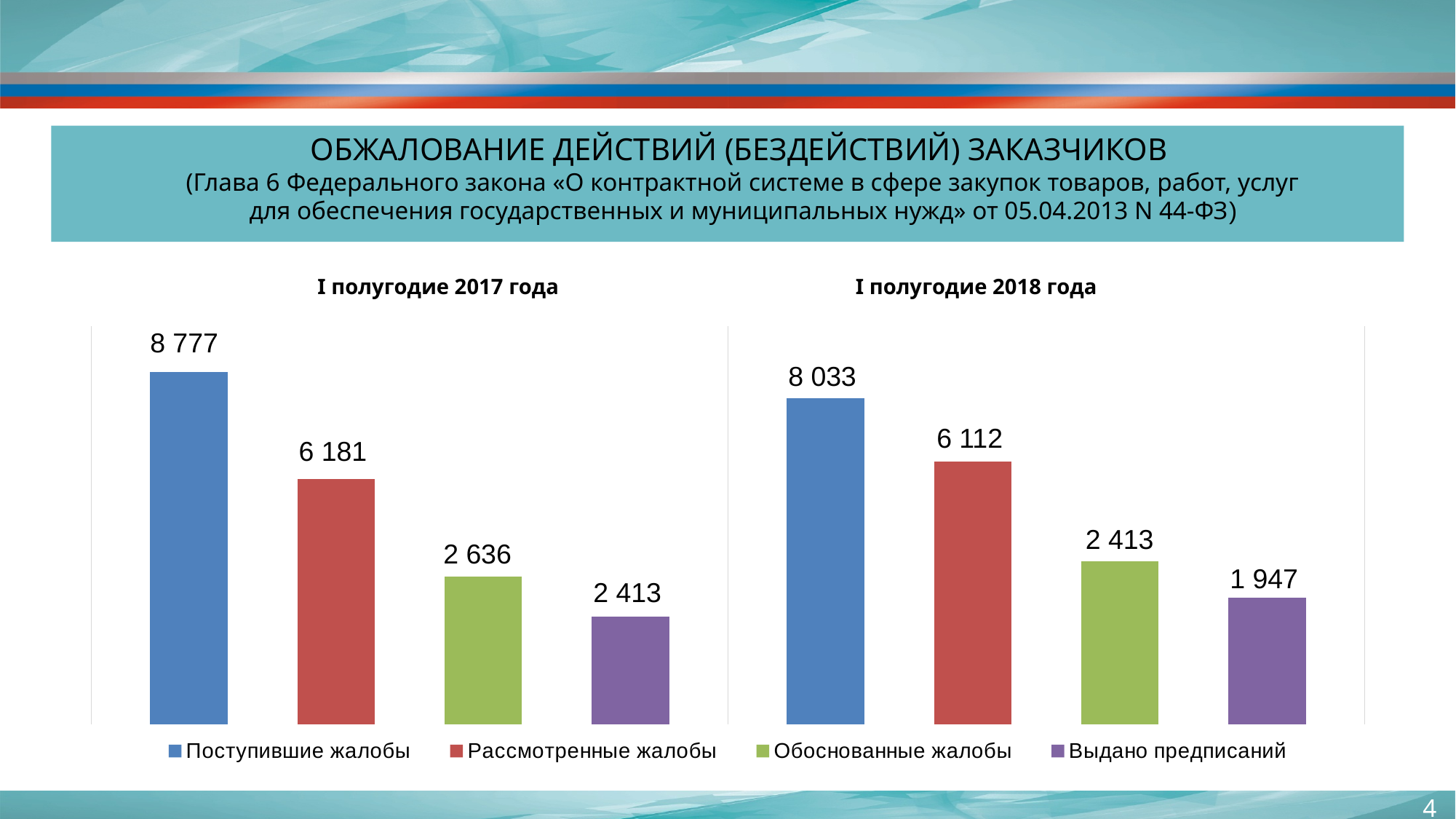
Which period has the larger value for Выдано предписаний, I полугодие 2017 года or I полугодие 2018 года? I полугодие 2017 года Which series has the lowest value in I полугодие 2017 года? Выдано предписаний What is the value for Поступившие жалобы in I полугодие 2017 года? 8 777 What kind of chart is shown on the slide? Bar chart What is the difference between Поступившие жалобы and Рассмотренные жалобы in I полугодие 2017 года? 2 596 What is the value for Рассмотренные жалобы in I полугодие 2017 года? 6 181 Which series has the highest value in I полугодие 2018 года? Поступившие жалобы How many series does the legend list? 4 What is the value for Обоснованные жалобы in I полугодие 2018 года? 2 413 What is the value for Выдано предписаний in I полугодие 2018 года? 1 947 How many periods (categories) are shown on the chart? 2 By how much did Поступившие жалобы decrease from I полугодие 2017 года to I полугодие 2018 года? 744